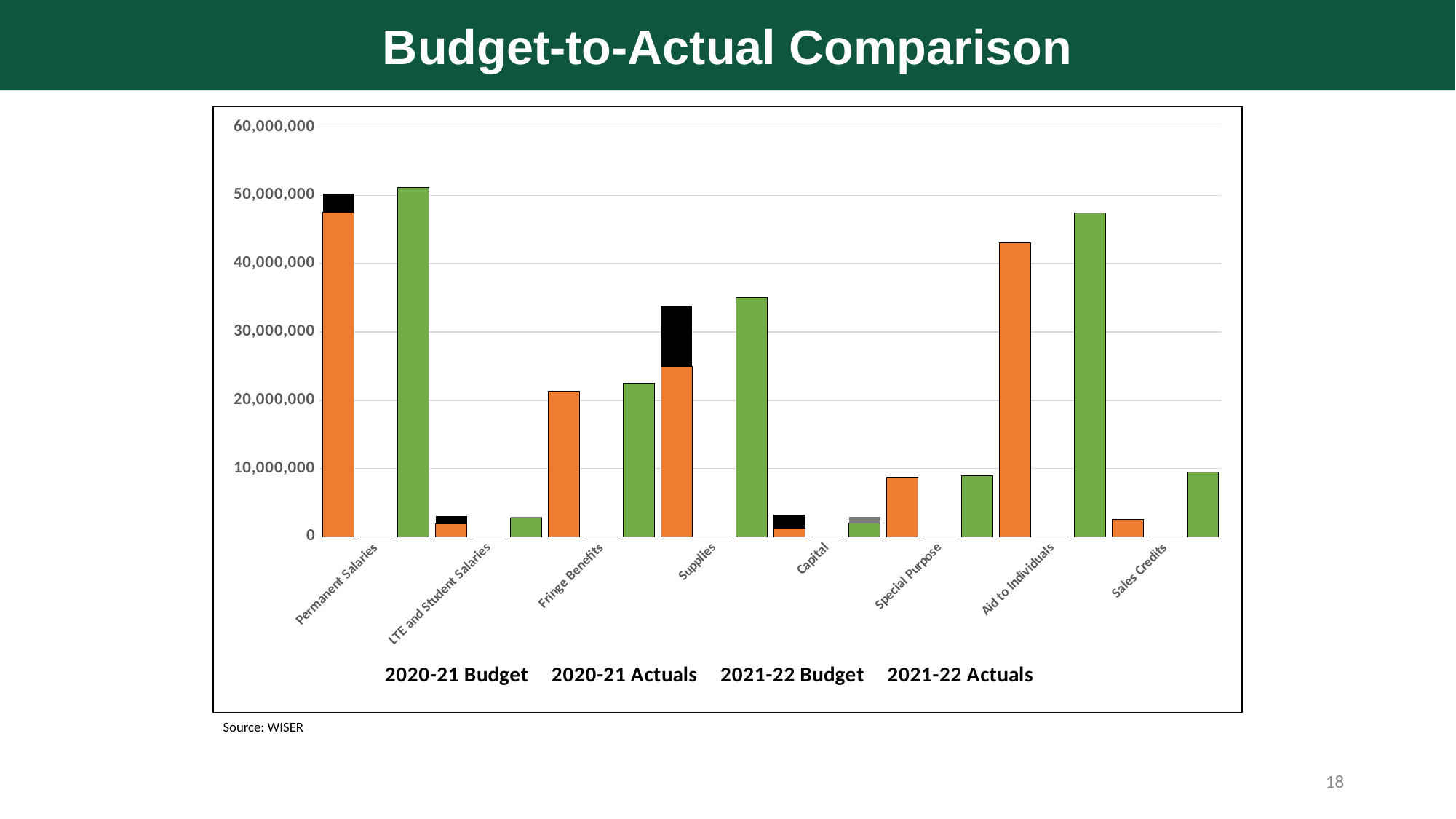
What kind of chart is shown on the slide? bar chart Which category has the shortest orange bar? Capital Which is larger, the orange bar for Supplies or the orange bar for Fringe Benefits? Supplies Is the value of the orange bar for Permanent Salaries greater or less than 40,000,000? greater What is the title of the slide containing the chart? Budget-to-Actual Comparison How many categories are shown along the x axis of the chart? 8 Which category has the tallest green bar? Permanent Salaries How many series does the chart's legend list? 4 Is the value of the green bar for Sales Credits greater or less than 10,000,000? less Is the value of the green bar for Aid to Individuals greater or less than 40,000,000? greater What source is cited below the chart? WISER